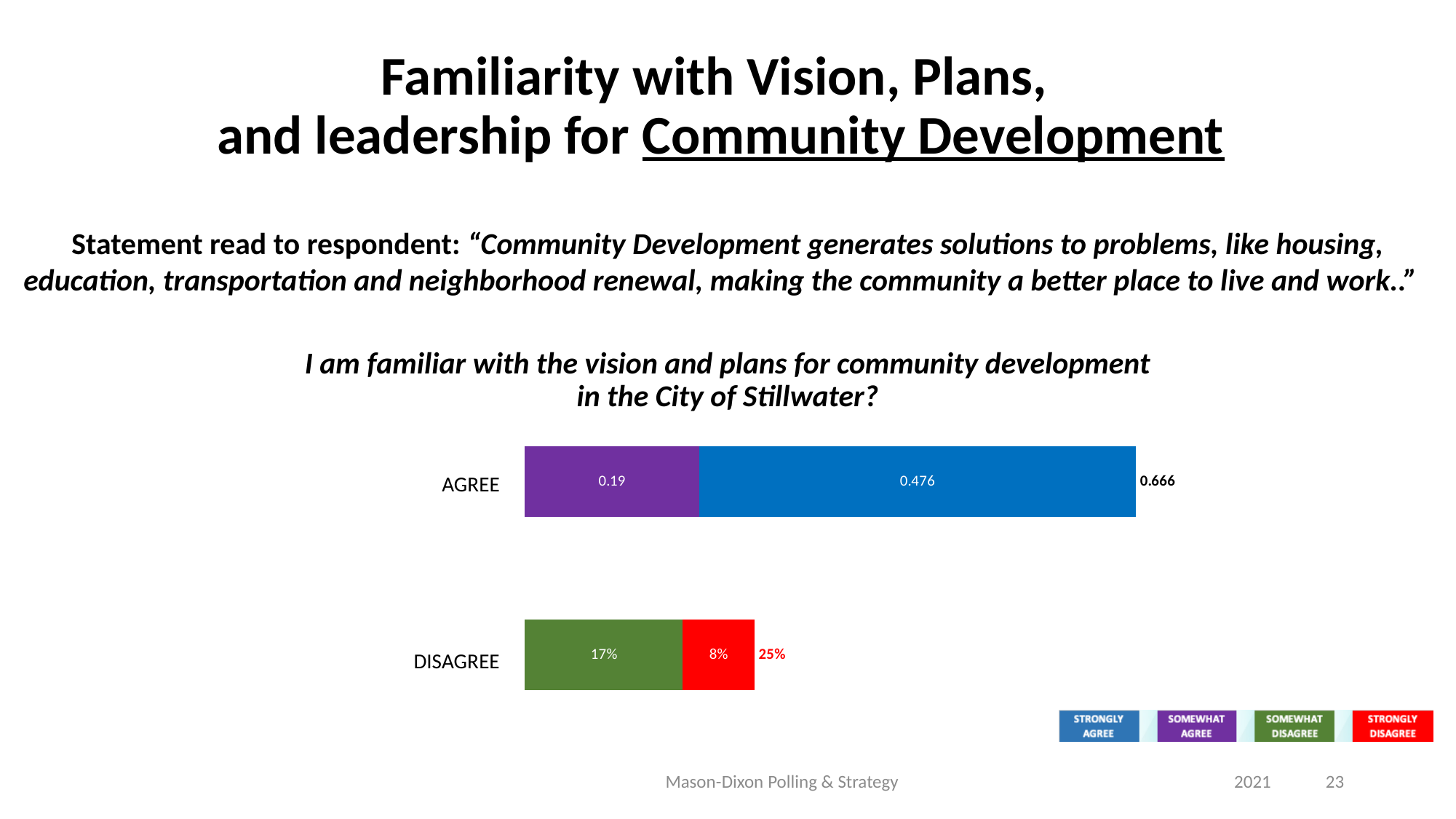
What value is printed on the purple segment of the AGREE bar? 0.19 What is the total printed at the end of the AGREE bar? 0.666 Which legend entry is shown in red? Strongly Disagree What is the total printed at the end of the DISAGREE bar? 25% Which bar is longer, AGREE or DISAGREE? AGREE How many entries does the legend list? 4 What value is printed on the blue segment of the AGREE bar? 0.476 What value is printed on the green segment of the DISAGREE bar? 17% How many categories (bars) does the chart show? 2 What kind of chart is shown on the slide? Stacked bar chart What value is printed on the red segment of the DISAGREE bar? 8% What is the difference between the green segment and the red segment of the DISAGREE bar? 9%